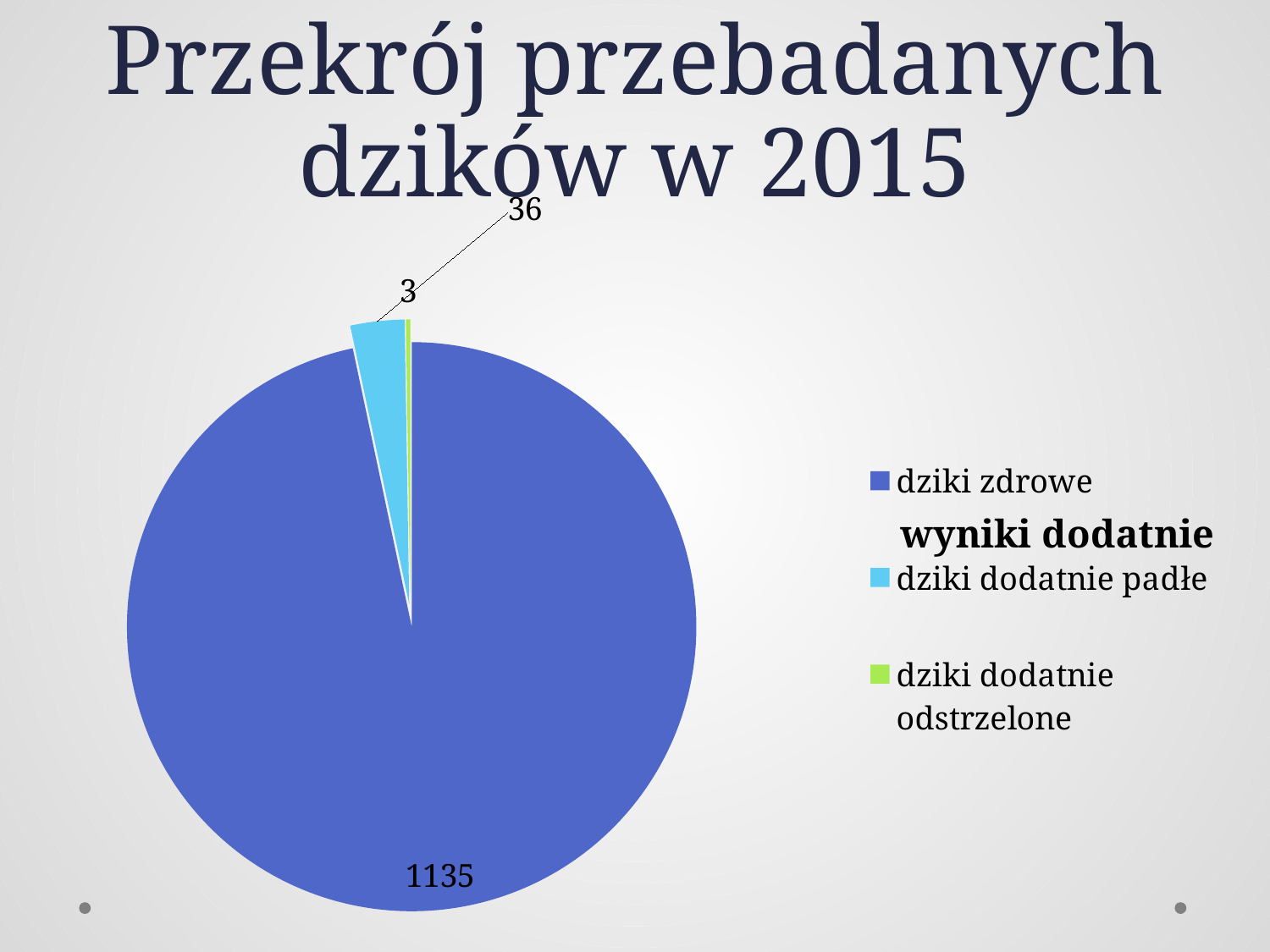
How many slices does the pie chart have? 3 What is the value for dziki dodatnie padłe? 36 Which category has the smallest slice of the pie? dziki dodatnie odstrzelone What is the value for dziki dodatnie odstrzelone? 3 What is the difference between the values for dziki zdrowe and dziki dodatnie padłe? 1099 Which category has the largest slice of the pie? dziki zdrowe What is the title of the chart on the slide? wyniki dodatnie What is the value for dziki zdrowe? 1135 What colour is the slice for dziki dodatnie odstrzelone? green What type of chart is shown on the slide? pie chart What is the difference between the values for dziki dodatnie padłe and dziki dodatnie odstrzelone? 33 Which is larger, the value for dziki dodatnie padłe or dziki dodatnie odstrzelone? dziki dodatnie padłe